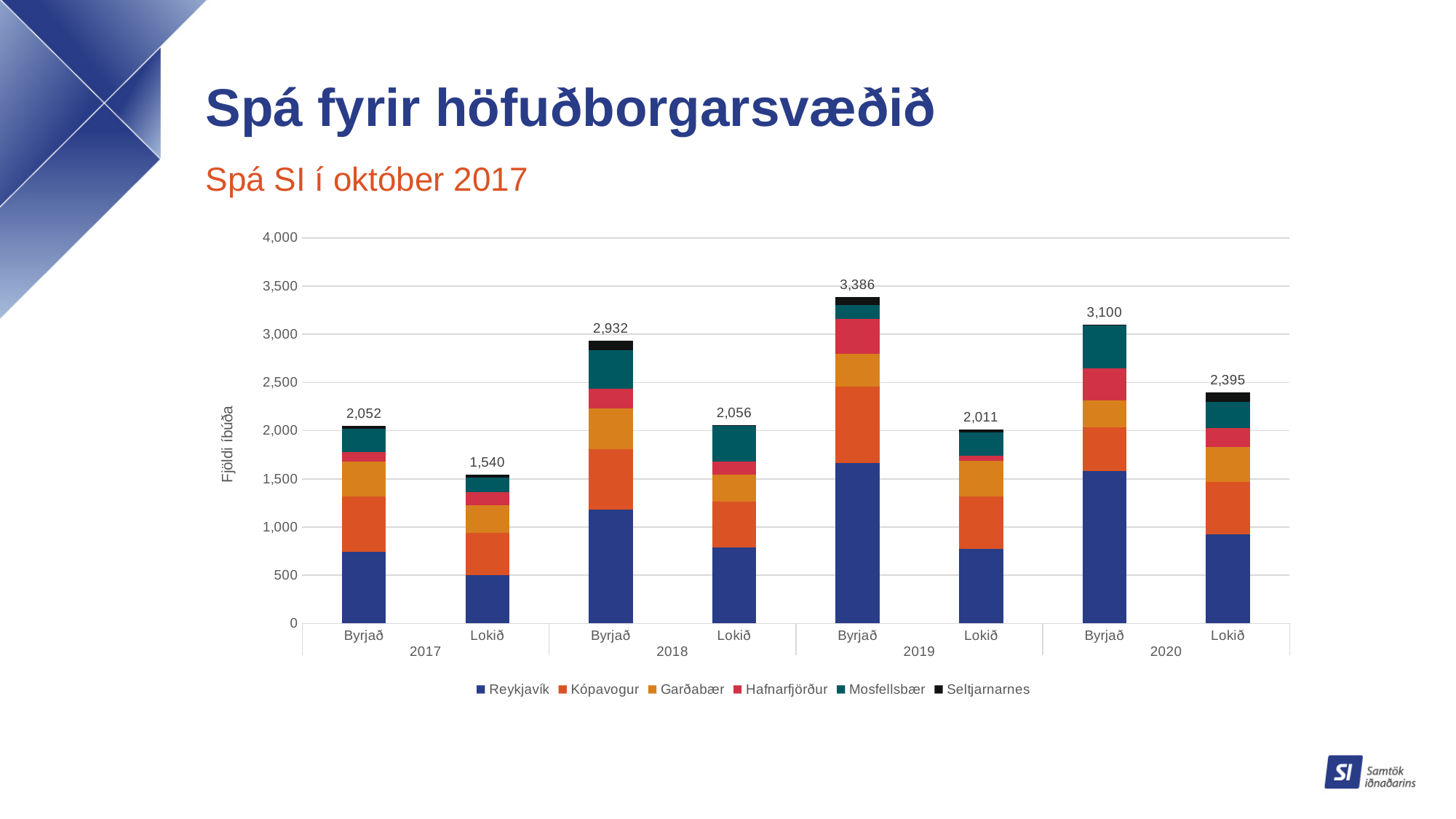
What type of chart is shown on the slide? Stacked bar chart Which bar has the highest total? Byrjað 2019 Is the Reykjavík value for Byrjað 2019 greater or less than 1,500? greater Is the Reykjavík value for Lokið 2017 greater or less than 1,000? less What is the difference between the totals for Byrjað 2018 and Lokið 2018? 876 How many series does the legend list? 6 What is the total shown for Lokið in 2017? 1,540 Which bar has the lowest total? Lokið 2017 How many bars are plotted in the chart? 8 Which is larger, the total for Lokið 2020 or the total for Lokið 2019? Lokið 2020 What is the total shown for Byrjað in 2020? 3,100 What is the total number of dwellings shown for Byrjað in 2019? 3,386